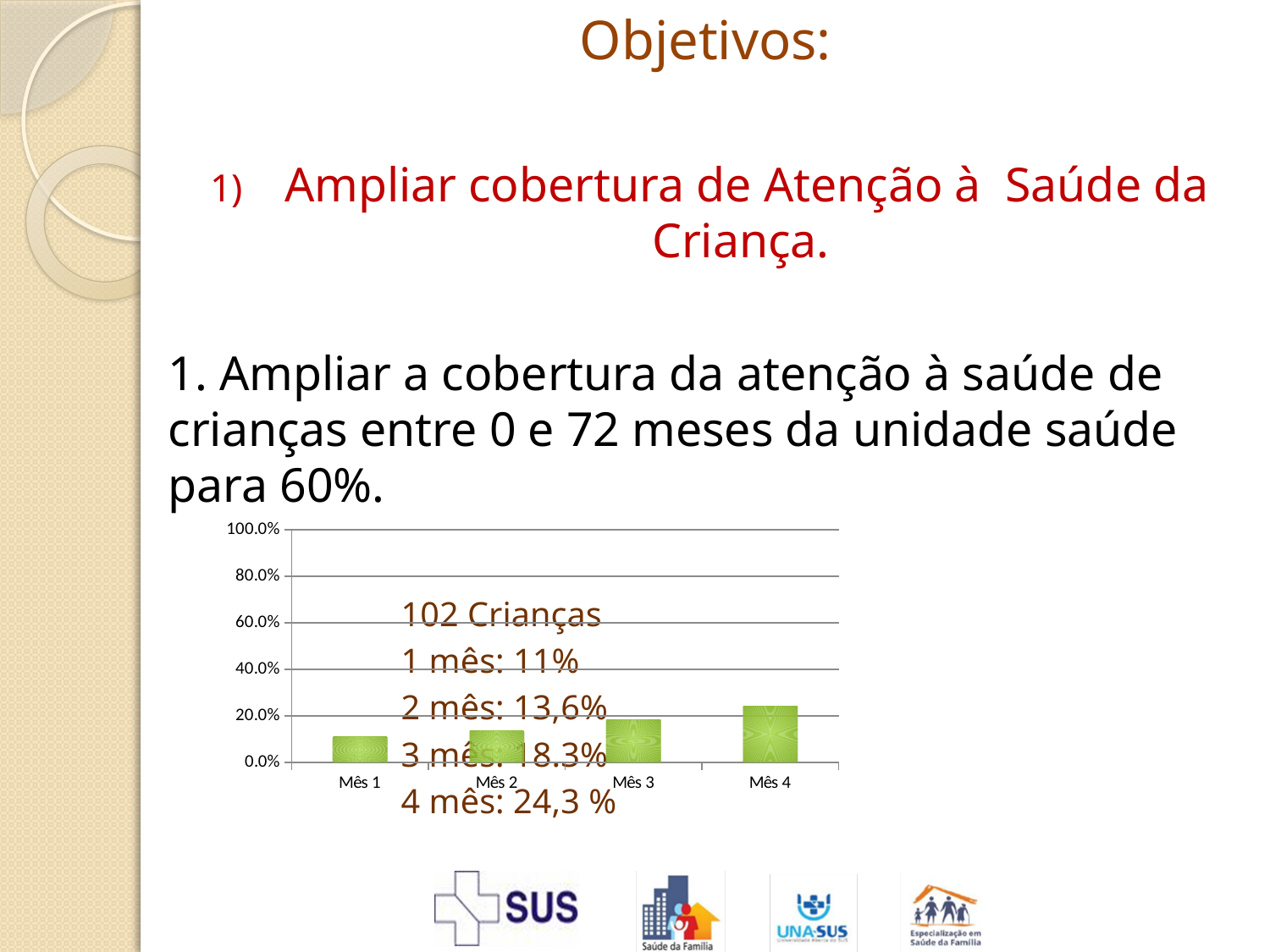
Is the value for Mês 4 greater or less than 20.0%? greater According to the text printed over the chart, what is the coverage value for the 1st month (1 mês)? 11% Which month has the highest bar in the chart? Mês 4 How many children (crianças) does the text over the chart mention? 102 Do the bar values rise or fall from Mês 1 to Mês 4? rise Which bar is taller, Mês 2 or Mês 3? Mês 3 According to the text printed over the chart, what is the coverage value for the 4th month (4 mês)? 24,3 % How many categories (months) are plotted on the x axis of the chart? 4 What kind of chart is shown on the slide? bar chart Which month has the lowest bar in the chart? Mês 1 Is the value for Mês 1 greater or less than 20.0%? less What is the highest value shown on the chart's y axis? 100.0%